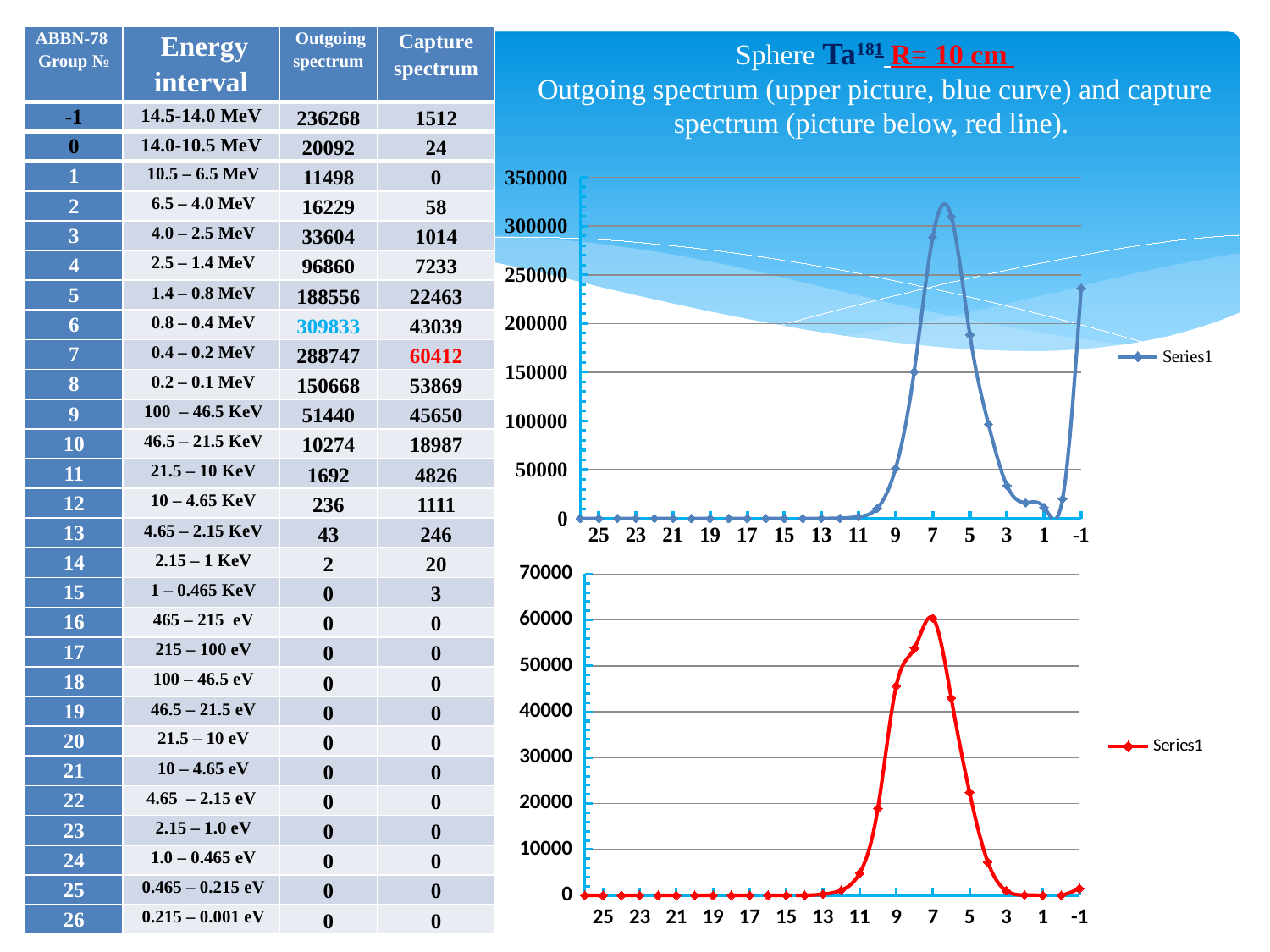
In the lower chart (red line), at which x-axis group does the curve reach its highest value? 7 In the upper chart (blue curve), is the value at group 5 greater or less than 200000? less In the lower chart (red line), is the value at group 4 greater or less than 10000? less How many series does the legend of the lower chart (red line) list? 1 In the upper chart (blue curve), is the peak value greater or less than 300000? greater In the upper chart (blue curve), at which x-axis group does the curve reach its highest value? 6 In the lower chart (red line), do the values rise or fall moving along the x axis from group 11 to group 7? rise What is the legend entry shown next to the upper chart? Series1 What type of chart is the upper chart (blue curve)? line chart In the upper chart (blue curve), which is larger, the value at group 6 or the value at group 7? group 6